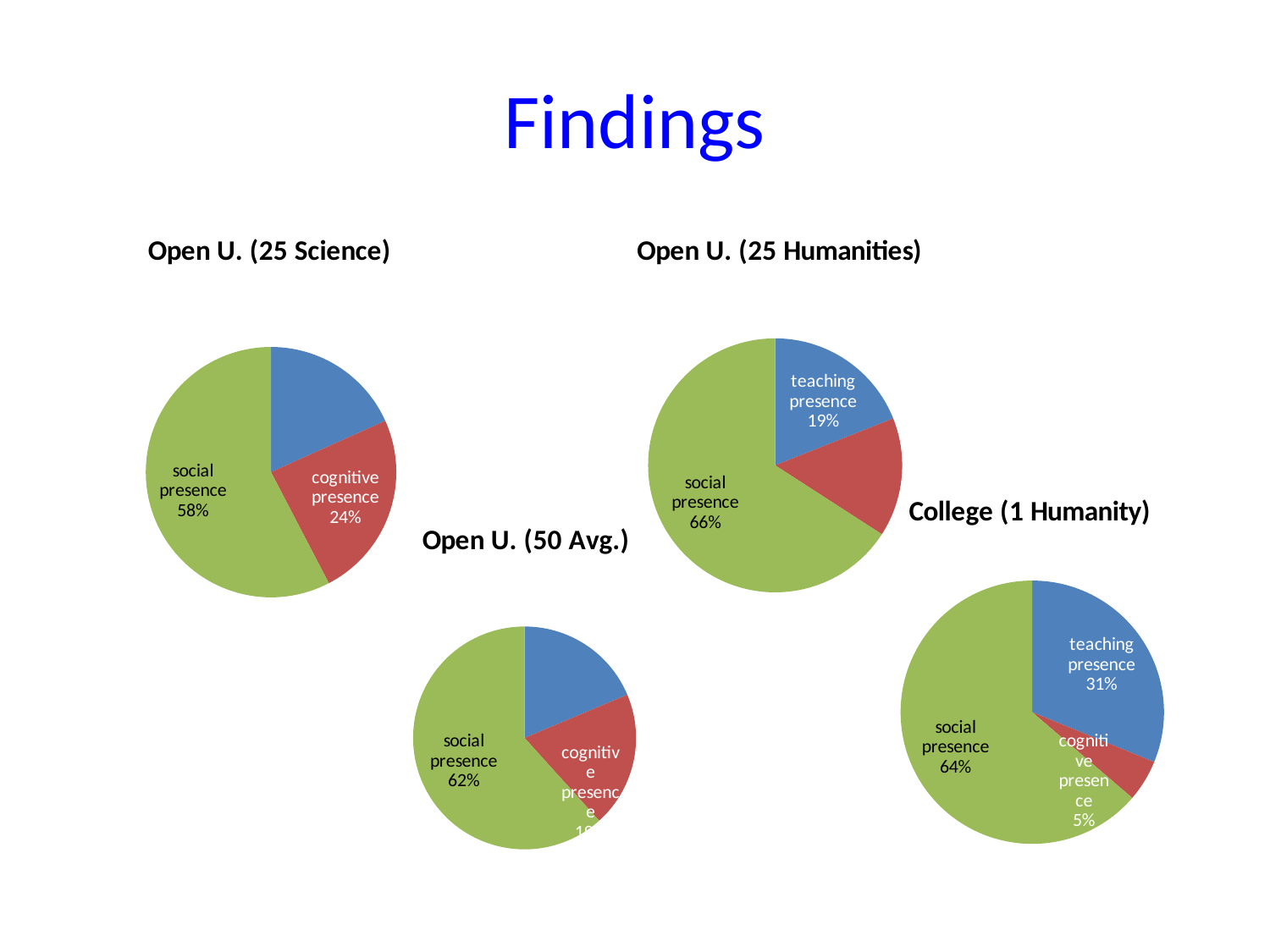
In the Open U. (25 Humanities) pie chart, what share is social presence? 66% In the Open U. (50 Avg.) pie chart, what share is social presence? 62% In the Open U. (25 Science) pie chart, what share is social presence? 58% In the College (1 Humanity) pie chart, what is the difference between the social presence and teaching presence shares? 33% In the Open U. (25 Science) pie chart, what share is cognitive presence? 24% In the Open U. (25 Humanities) pie chart, which category has the largest slice? social presence In the College (1 Humanity) pie chart, which category has the smallest slice? cognitive presence In the Open U. (25 Humanities) pie chart, what share is teaching presence? 19% Which is larger in the Open U. (25 Science) pie chart: social presence or cognitive presence? social presence In the College (1 Humanity) pie chart, what share is cognitive presence? 5% In the College (1 Humanity) pie chart, what share is teaching presence? 31% What type of chart is used for the Open U. (50 Avg.) data? pie chart